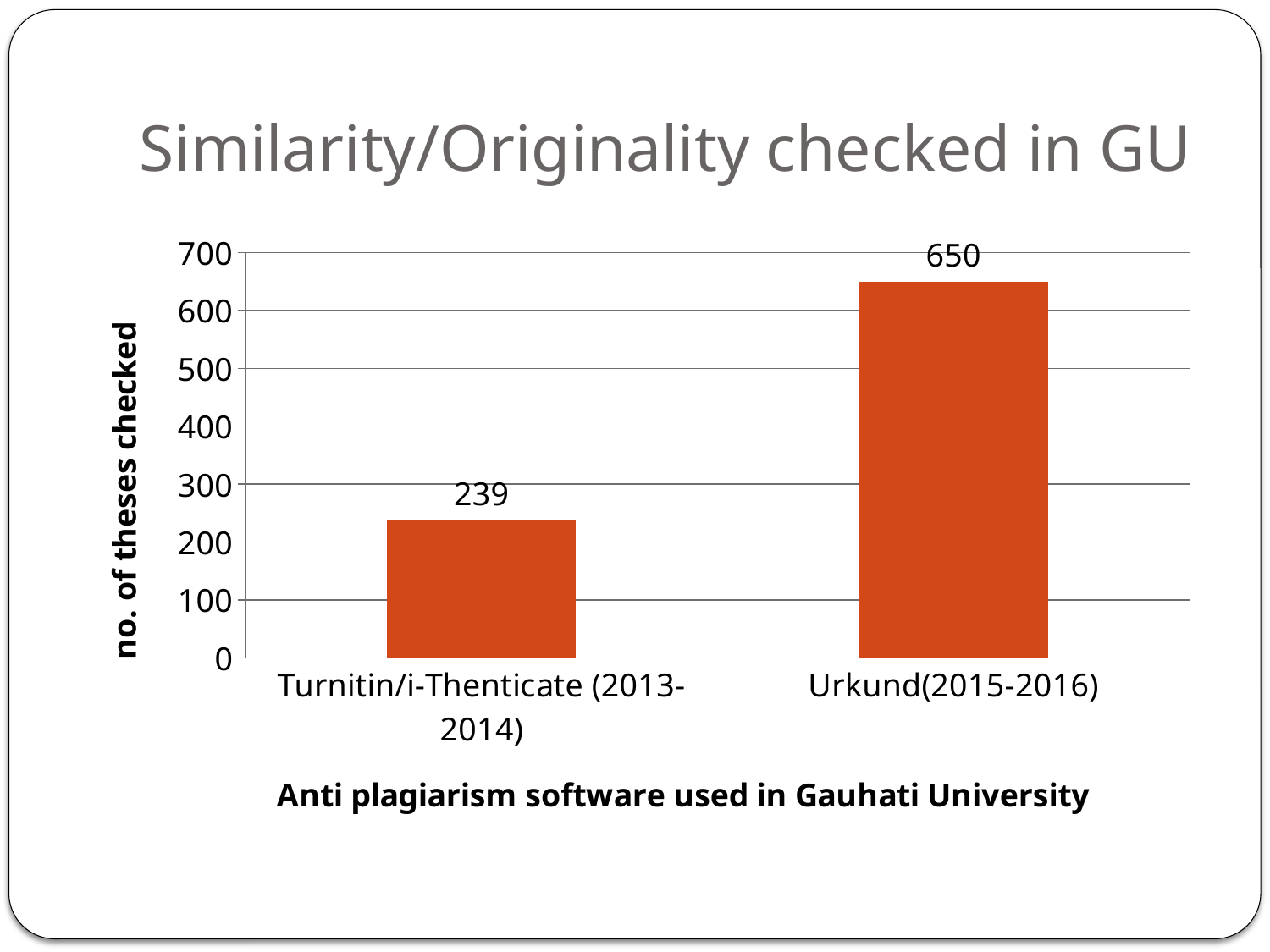
What is the label of the y axis? no. of theses checked How many theses were checked with Turnitin/i-Thenticate (2013-2014)? 239 What is the label of the x axis? Anti plagiarism software used in Gauhati University Which anti-plagiarism software has the lowest number of theses checked? Turnitin/i-Thenticate (2013-2014) What kind of chart is shown on the slide? Bar chart How many categories are shown on the x axis of the chart? 2 What is the difference between the number of theses checked with Urkund and with Turnitin/i-Thenticate? 411 Is the value for Urkund (2015-2016) greater or less than 600? greater Which anti-plagiarism software has the highest number of theses checked? Urkund(2015-2016) Is the value for Turnitin/i-Thenticate (2013-2014) greater or less than 300? less How many theses were checked with Urkund (2015-2016)? 650 Which had more theses checked, Turnitin/i-Thenticate or Urkund? Urkund